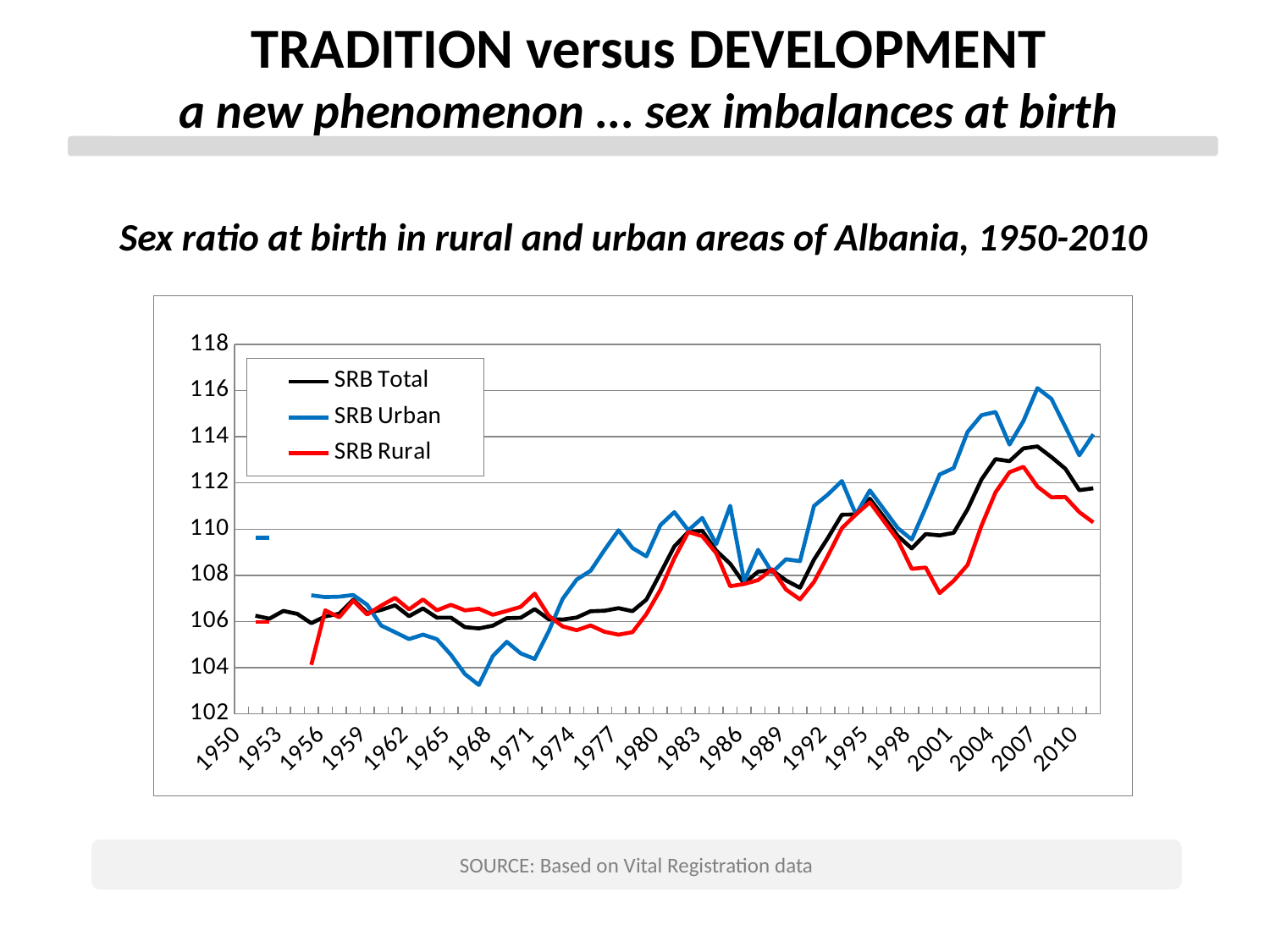
What colour is the SRB Rural line? red Overall, does the SRB Total line rise or fall from 1950 to 2010? rise Which series are listed in the chart legend? SRB Total, SRB Urban, SRB Rural What kind of chart is shown on the slide? line chart In 2007, which is higher: SRB Urban or SRB Rural? SRB Urban Is the value for SRB Urban in 2007 greater or less than 114? greater How many series does the chart legend list? 3 Which series reaches the highest value anywhere on the chart? SRB Urban Is the value for SRB Total in 2010 greater or less than 110? greater